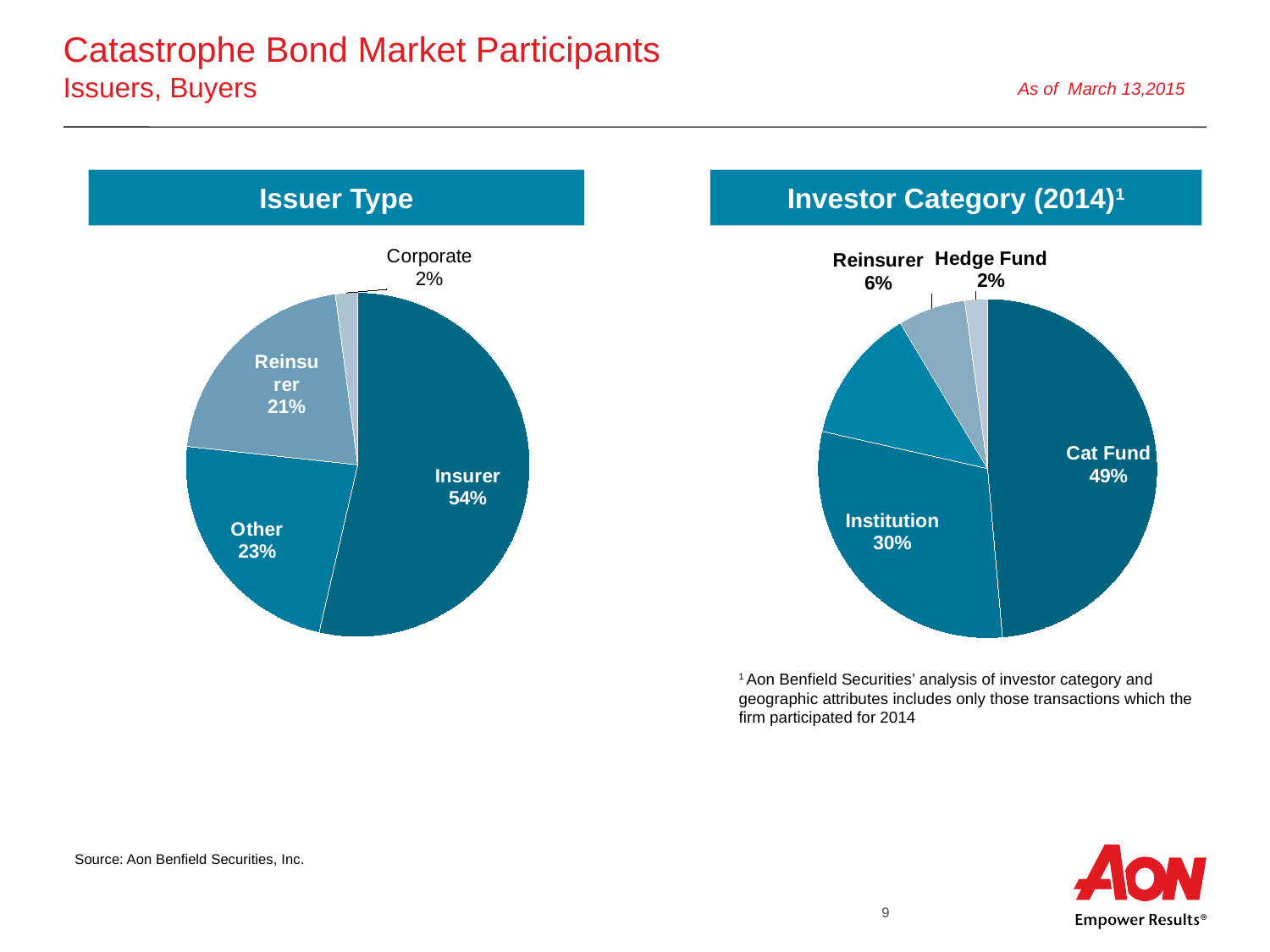
In the Issuer Type chart, what share of the pie is Insurer? 54% How many categories are shown in the Issuer Type pie chart? 4 What type of chart is used for the Investor Category (2014) data? Pie chart How many categories are shown in the Investor Category (2014) pie chart? 5 In the Investor Category (2014) chart, what percentage is shown for Institution? 30% In the Investor Category (2014) chart, what is the difference between the Cat Fund and Institution shares? 19% In the Investor Category (2014) chart, what share of the pie is Cat Fund? 49% In the Issuer Type chart, what percentage is shown for Reinsurer? 21% In the Issuer Type chart, which category has the smallest slice? Corporate In the Issuer Type chart, what is the difference between the Other and Reinsurer shares? 2% In the Investor Category (2014) chart, which is larger, Reinsurer or Hedge Fund? Reinsurer In the Issuer Type chart, which category has the largest slice? Insurer